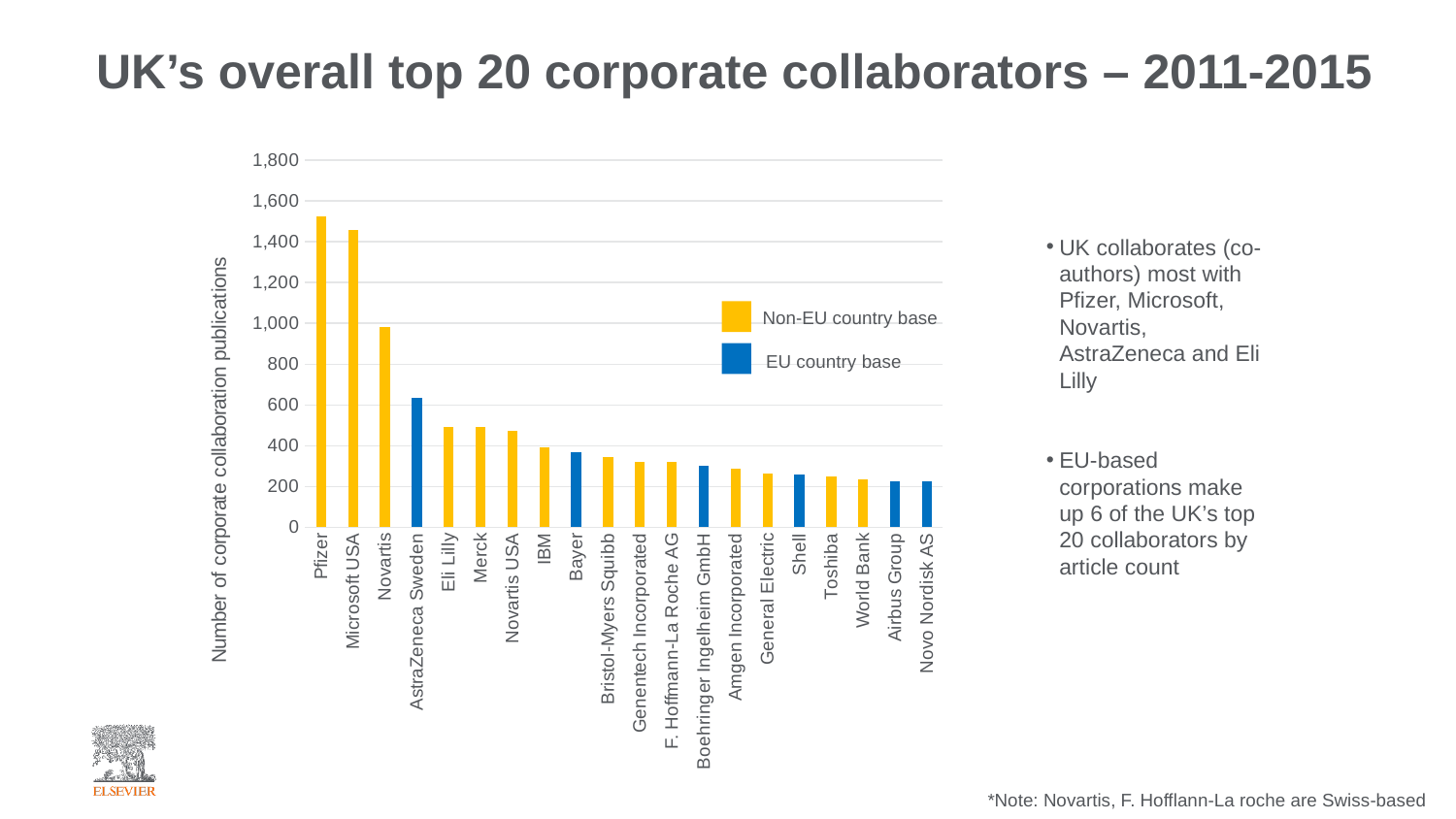
Is the value for Pfizer greater or less than 1,400? greater How many corporate collaborators are shown on the x axis of the chart? 20 What kind of chart is shown on the slide? bar chart Which colour represents the EU country base series in the legend? blue What is the title of the y axis of the chart? Number of corporate collaboration publications Do the bar values rise or fall moving from left to right along the x axis? fall Is the value for AstraZeneca Sweden greater or less than 600? greater Which corporate collaborator has the highest number of corporate collaboration publications? Pfizer Which has more corporate collaboration publications, Novartis or AstraZeneca Sweden? Novartis How many series does the chart legend list? 2